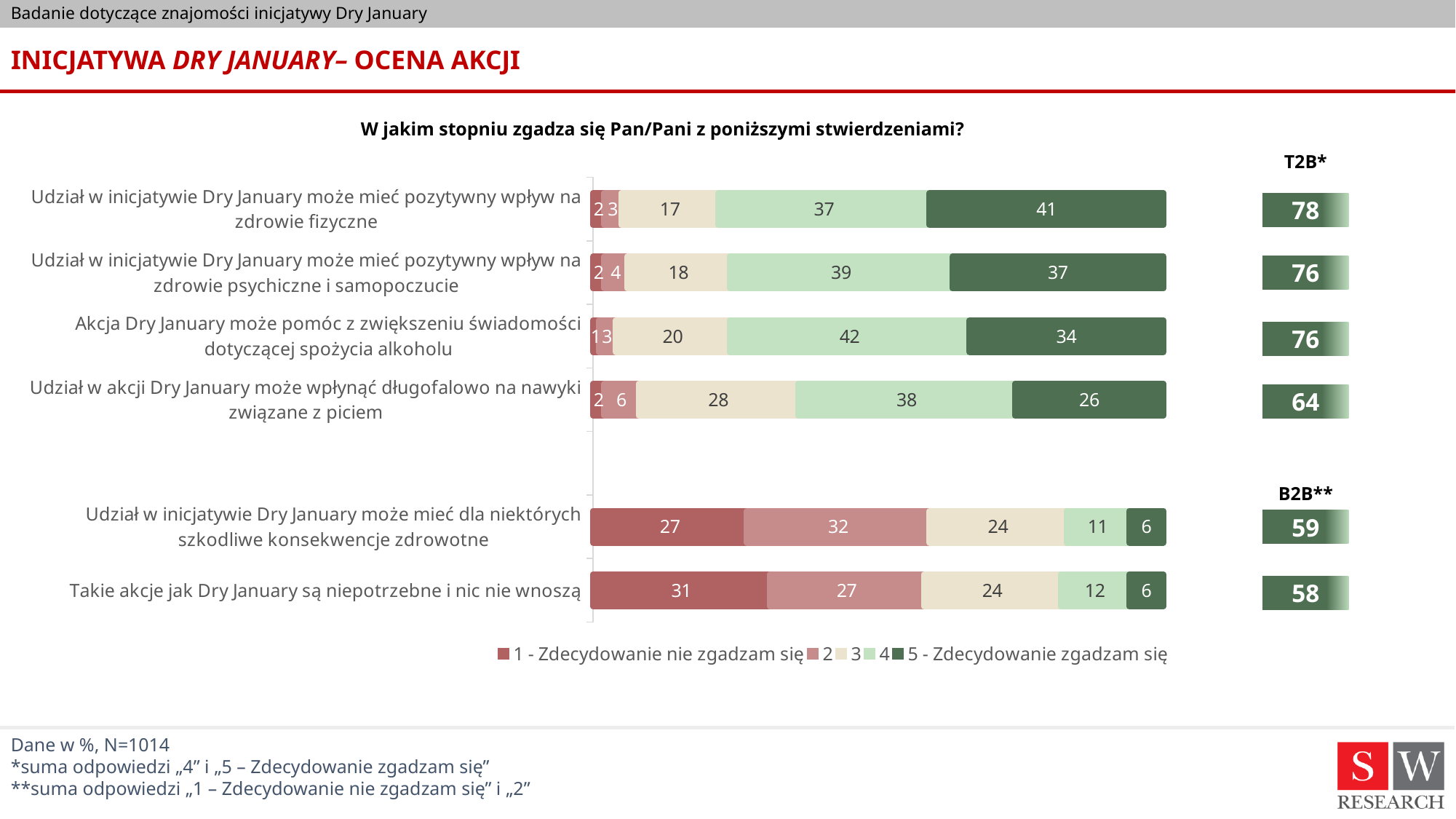
What is the difference between the "5 - Zdecydowanie zgadzam się" values for the statements about "zdrowie fizyczne" and "zdrowie psychiczne i samopoczucie"? 4 How many series does the legend list? 5 What percentage of respondents answered "5 - Zdecydowanie zgadzam się" for the statement "Udział w inicjatywie Dry January może mieć pozytywny wpływ na zdrowie fizyczne"? 41 What is the T2B value for the statement "Udział w akcji Dry January może wpłynąć długofalowo na nawyki związane z piciem"? 64 Which statement has the highest T2B value? Udział w inicjatywie Dry January może mieć pozytywny wpływ na zdrowie fizyczne What kind of chart is shown on the slide? Stacked bar chart What is the value for "1 - Zdecydowanie nie zgadzam się" for the statement "Takie akcje jak Dry January są niepotrzebne i nic nie wnoszą"? 31 Which statement has the lowest value for answer "3"? Udział w inicjatywie Dry January może mieć pozytywny wpływ na zdrowie fizyczne Which statement has a larger value for answer "3": "Udział w akcji Dry January może wpłynąć długofalowo na nawyki związane z piciem" or "Udział w inicjatywie Dry January może mieć pozytywny wpływ na zdrowie fizyczne"? Udział w akcji Dry January może wpłynąć długofalowo na nawyki związane z piciem What is the value for answer "4" for the statement "Akcja Dry January może pomóc z zwiększeniu świadomości dotyczącej spożycia alkoholu"? 42 What is the B2B value for the statement "Udział w inicjatywie Dry January może mieć dla niektórych szkodliwe konsekwencje zdrowotne"? 59 How many statements are shown in the chart? 6